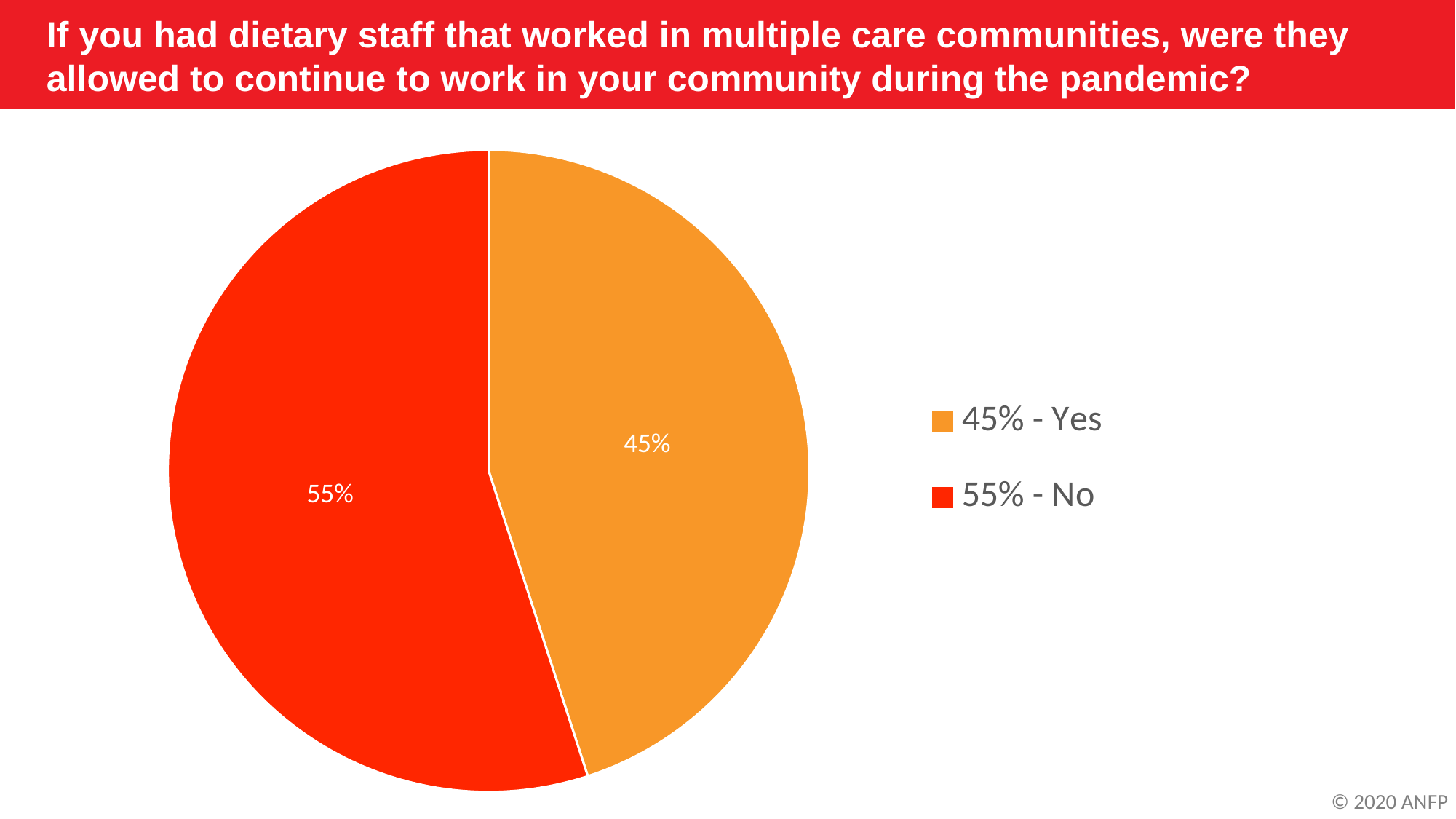
Which response has the smaller share of the pie? Yes How many slices does the pie chart have? 2 Is the share for Yes greater or less than 50%? less How many entries does the legend list? 2 Which response has the larger share of the pie? No What is the difference in percentage points between the No and Yes responses? 10 What percentage of respondents answered No? 55% What kind of chart is shown on the slide? pie chart What percentage of respondents answered Yes? 45% What colour is the slice representing No? red Which is larger, the share for Yes or the share for No? No What colour is the slice representing Yes? orange